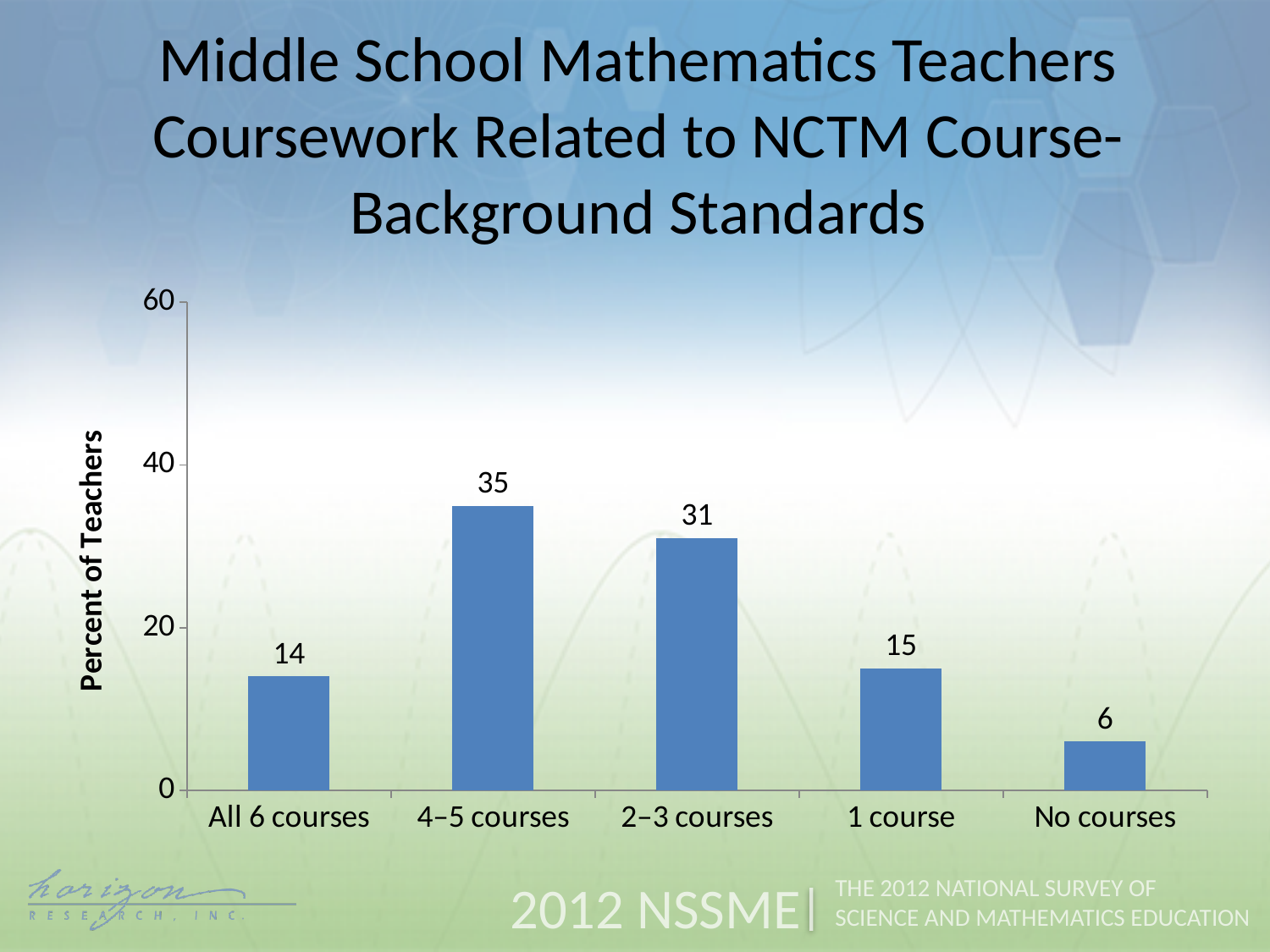
Which category has the highest percent of teachers? 4–5 courses What is the label of the y axis? Percent of Teachers What is the value for 4–5 courses? 35 What percent of teachers took no courses? 6 What is the difference between the values for 4–5 courses and 2–3 courses? 4 Which is larger, the value for All 6 courses or the value for 1 course? 1 course How many categories are shown on the x axis? 5 What percent of teachers took all 6 courses? 14 What is the difference between the values for 1 course and No courses? 9 What kind of chart is shown on the slide? bar chart Which category has the lowest percent of teachers? No courses Is the value for 2–3 courses greater or less than 20? greater